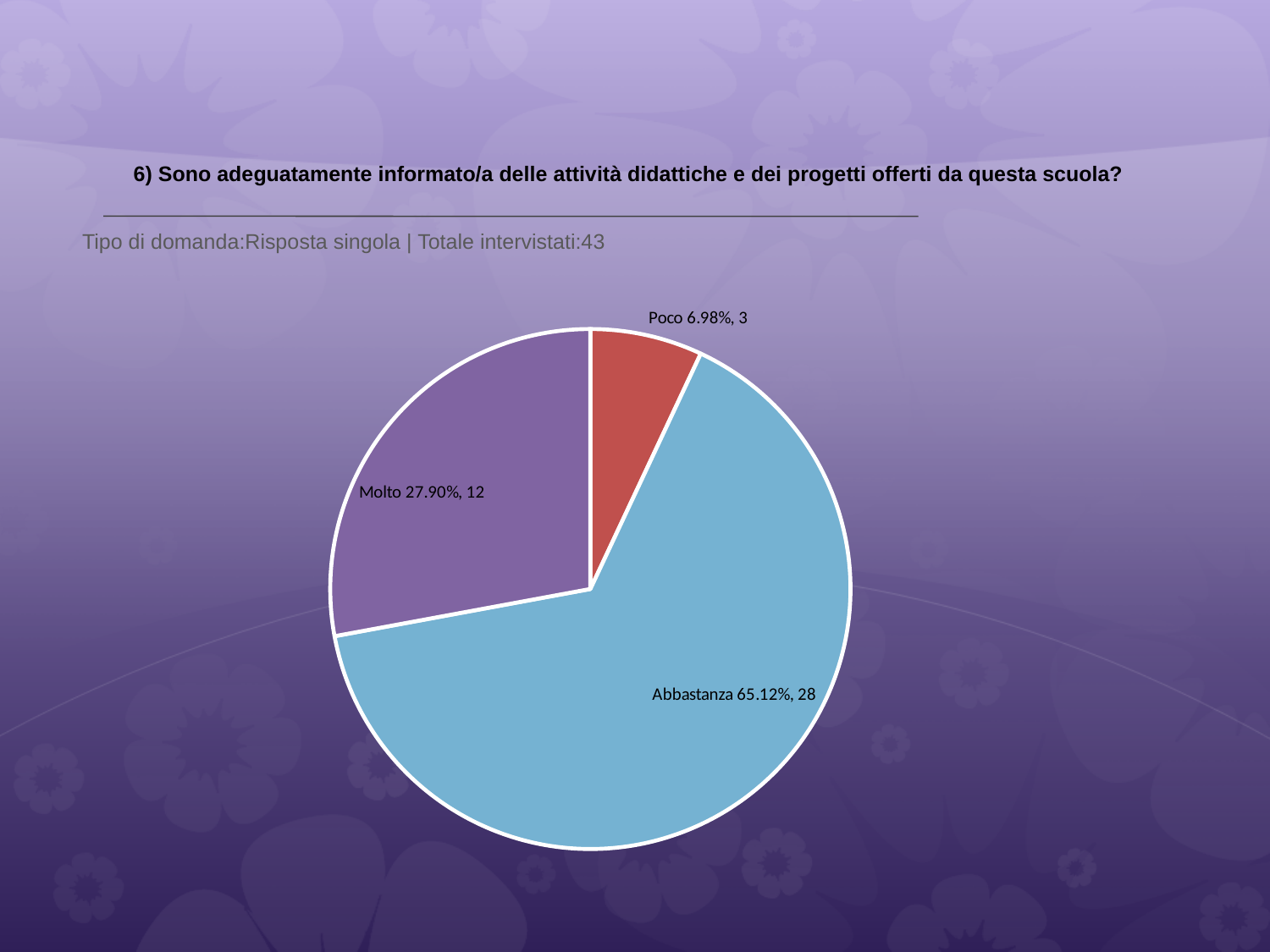
How many respondents answered Poco? 3 What percentage share does the Abbastanza slice have? 65.12% Which category has the smallest slice? Poco Which category has the largest slice? Abbastanza Which slice is larger, Molto or Poco? Molto How many respondents answered Molto? 12 What percentage share does the Poco slice have? 6.98% How many respondents answered Abbastanza? 28 How many slices does the pie chart have? 3 What percentage share does the Molto slice have? 27.90% What is the difference in respondent count between Abbastanza and Molto? 16 What kind of chart is shown on the slide? pie chart